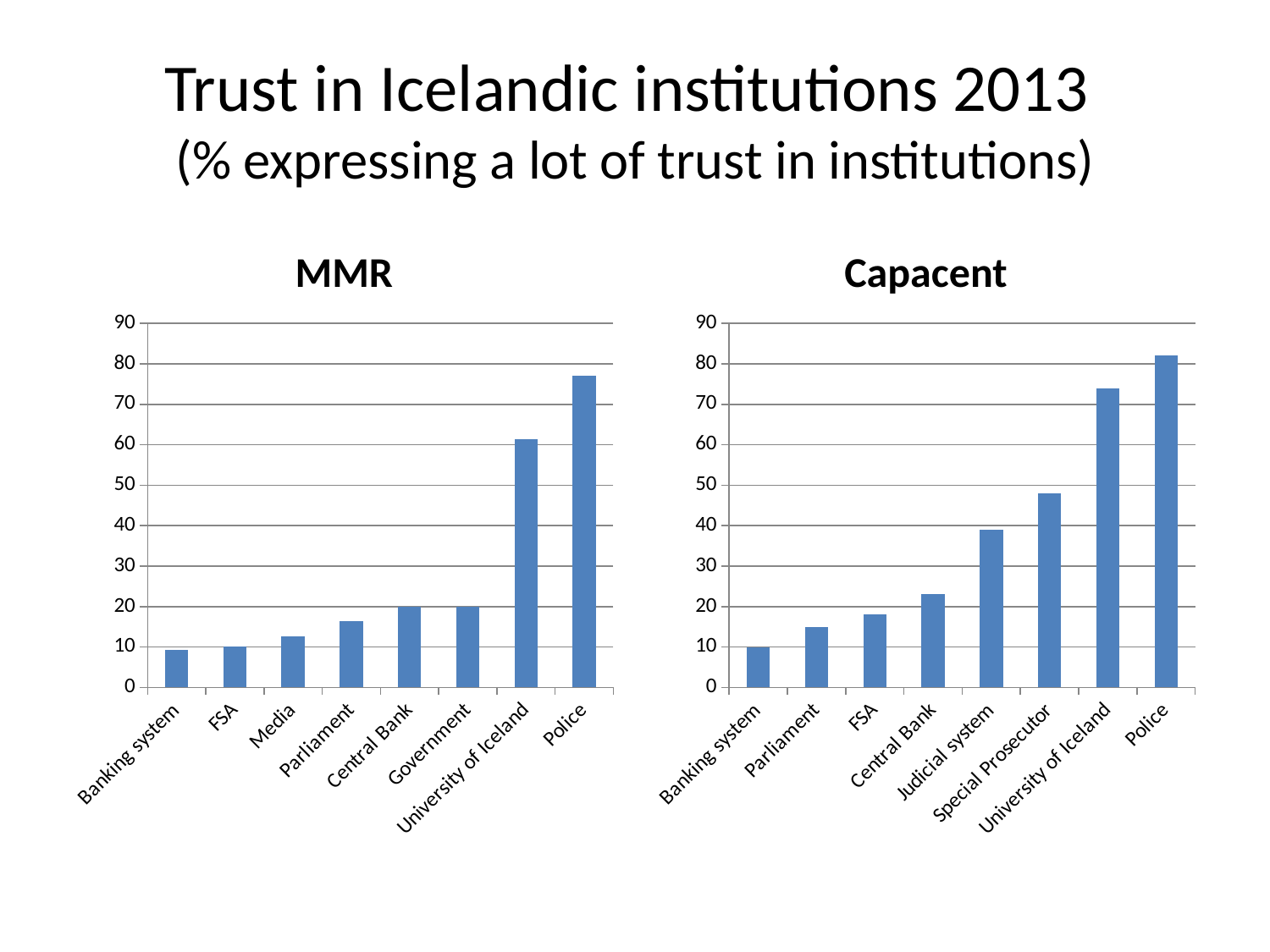
In the Capacent chart, which institution has the highest value? Police Do the values in the Capacent chart rise or fall from left to right? rise In the MMR chart, which institution has the lowest value? Banking system In the Capacent chart, is the value for Special Prosecutor greater or less than 50? less In the Capacent chart, which institution has the lowest value? Banking system In the Capacent chart, is the value for Police greater or less than 80? greater In the MMR chart, is the value for University of Iceland greater or less than 60? greater In the MMR chart, which institution has the highest value? Police How many institutions are shown in the Capacent chart? 8 What kind of chart is the MMR chart? bar chart In the Capacent chart, which is larger, the value for Judicial system or the value for Central Bank? Judicial system How many institutions are shown in the MMR chart? 8